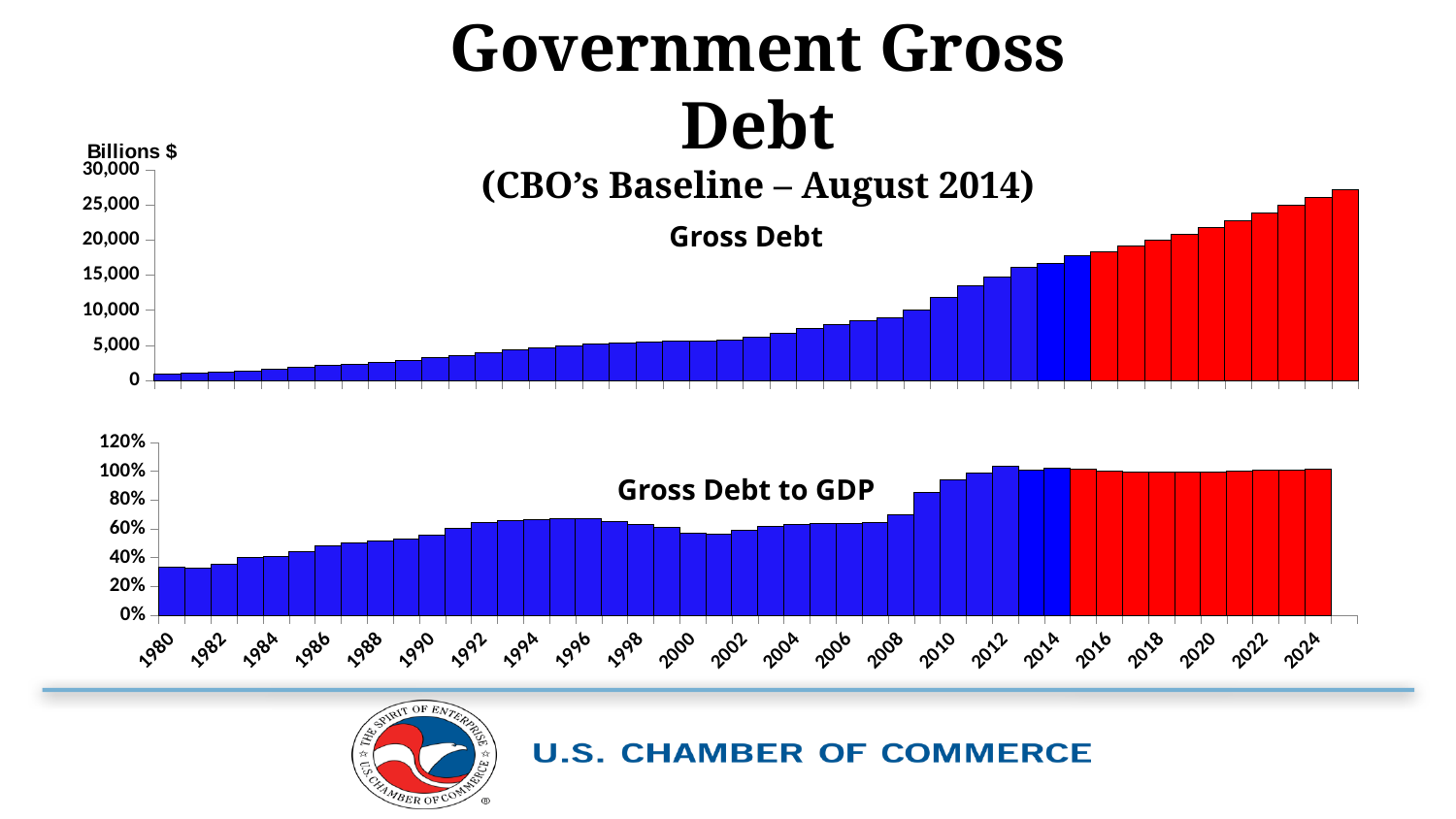
What kind of chart is the Gross Debt to GDP chart at the bottom of the slide? bar chart In the Gross Debt chart, which year has the lowest value? 1980 In the Gross Debt chart, is the value for 1980 greater or less than 5,000? less In the Gross Debt to GDP chart, which is larger, the value for 1996 or the value for 2002? 1996 In the Gross Debt chart, do the values generally rise or fall from 1980 to 2024? rise In the Gross Debt to GDP chart, is the value for 2012 greater or less than 80%? greater What unit is shown on the y axis of the Gross Debt chart? Billions $ In the Gross Debt to GDP chart, is the value for 1980 greater or less than 40%? less What kind of chart is the Gross Debt chart at the top of the slide? bar chart In the Gross Debt chart, which is larger, the value for 2000 or the value for 2010? 2010